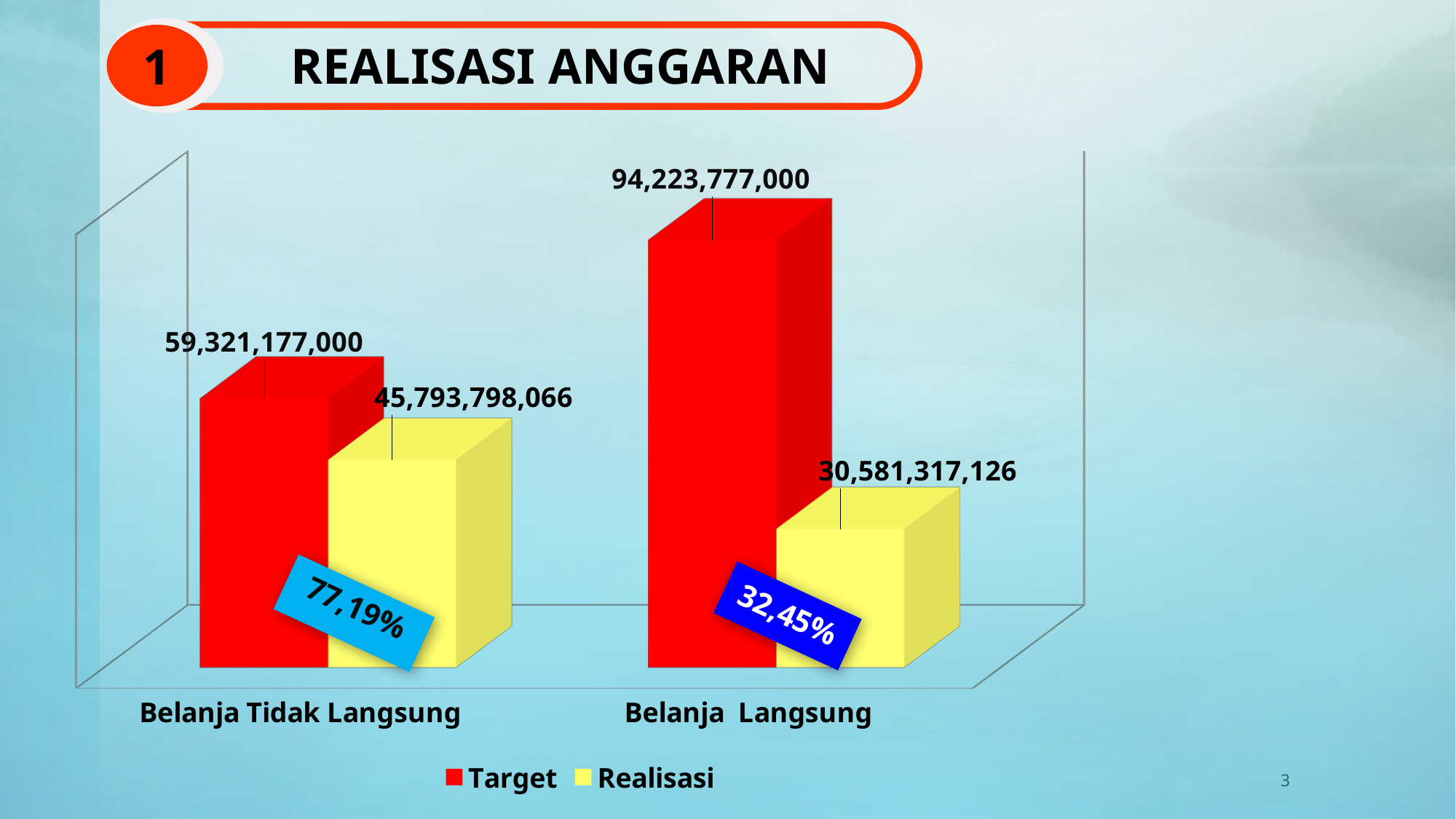
Which is larger: the Realisasi value for Belanja Tidak Langsung or the Realisasi value for Belanja Langsung? Belanja Tidak Langsung How many categories are shown on the x axis of the chart? 2 What is the Realisasi value for Belanja Tidak Langsung? 45,793,798,066 How many series does the chart legend list? 2 What is the difference between the Target and Realisasi values for Belanja Langsung? 63,642,459,874 Which category has the highest Target value? Belanja Langsung What type of chart is shown on the slide? Bar chart What is the difference between the Target and Realisasi values for Belanja Tidak Langsung? 13,527,378,934 Which category has the lowest Realisasi value? Belanja Langsung What is the Target value for Belanja Tidak Langsung? 59,321,177,000 What is the Realisasi value for Belanja Langsung? 30,581,317,126 What is the Target value for Belanja Langsung? 94,223,777,000